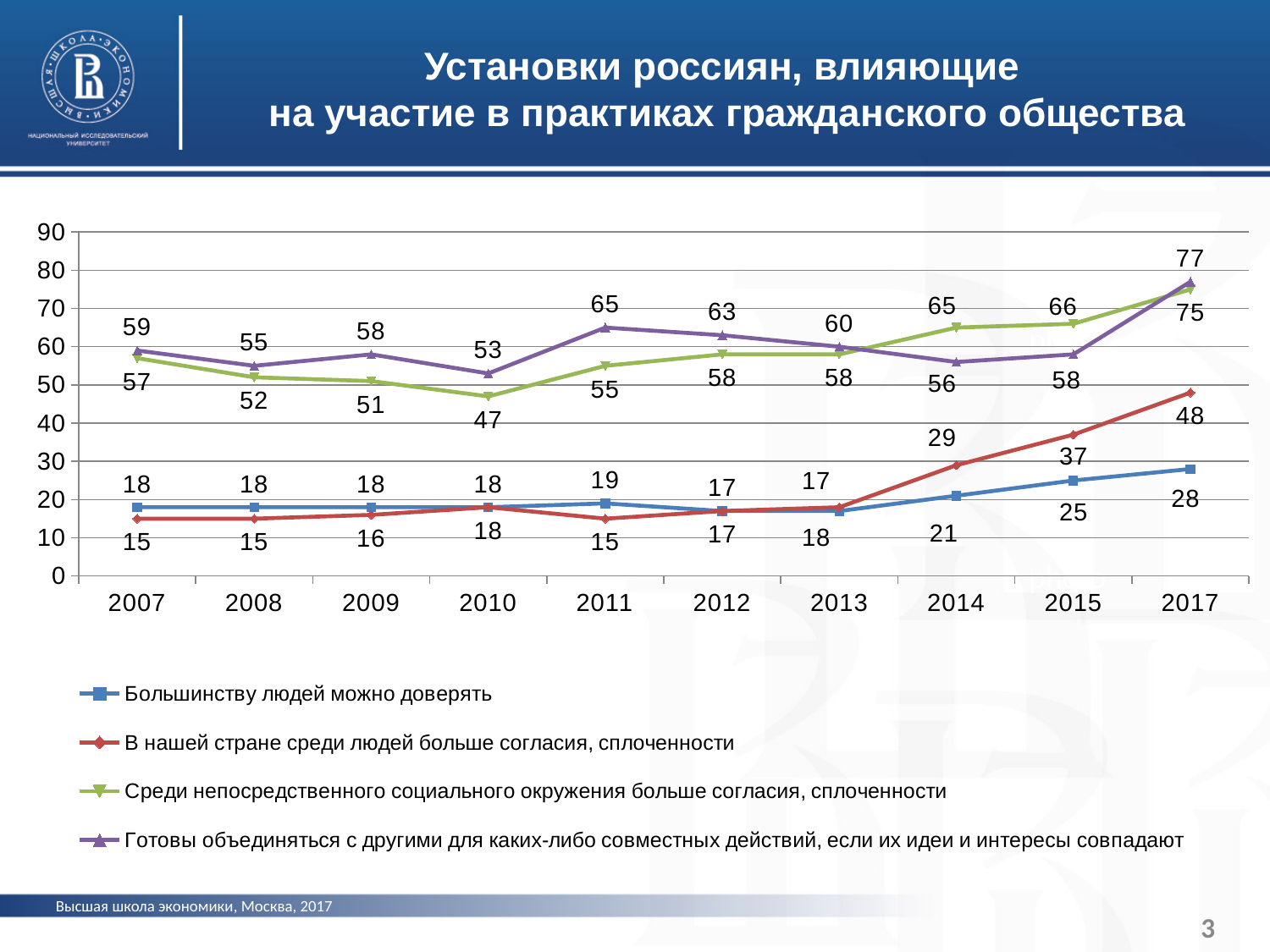
What is the value for 'Большинству людей можно доверять' in 2017? 28 In which year does 'Готовы объединяться с другими для каких-либо совместных действий, если их идеи и интересы совпадают' reach its highest value? 2017 In which year is 'Среди непосредственного социального окружения больше согласия, сплоченности' at its lowest value? 2010 Does the value for 'В нашей стране среди людей больше согласия, сплоченности' rise or fall from 2013 to 2017? rise How many years are shown on the x axis? 10 What is the value for 'В нашей стране среди людей больше согласия, сплоченности' in 2015? 37 How many series does the legend list? 4 In 2014, which series has the larger value: 'Среди непосредственного социального окружения больше согласия, сплоченности' or 'Готовы объединяться с другими для каких-либо совместных действий, если их идеи и интересы совпадают'? Среди непосредственного социального окружения больше согласия, сплоченности What is the value for 'Среди непосредственного социального окружения больше согласия, сплоченности' in 2010? 47 What type of chart is shown on the slide? line chart What colour is the line for 'Большинству людей можно доверять'? blue What is the difference between the 2017 and 2007 values for 'В нашей стране среди людей больше согласия, сплоченности'? 33